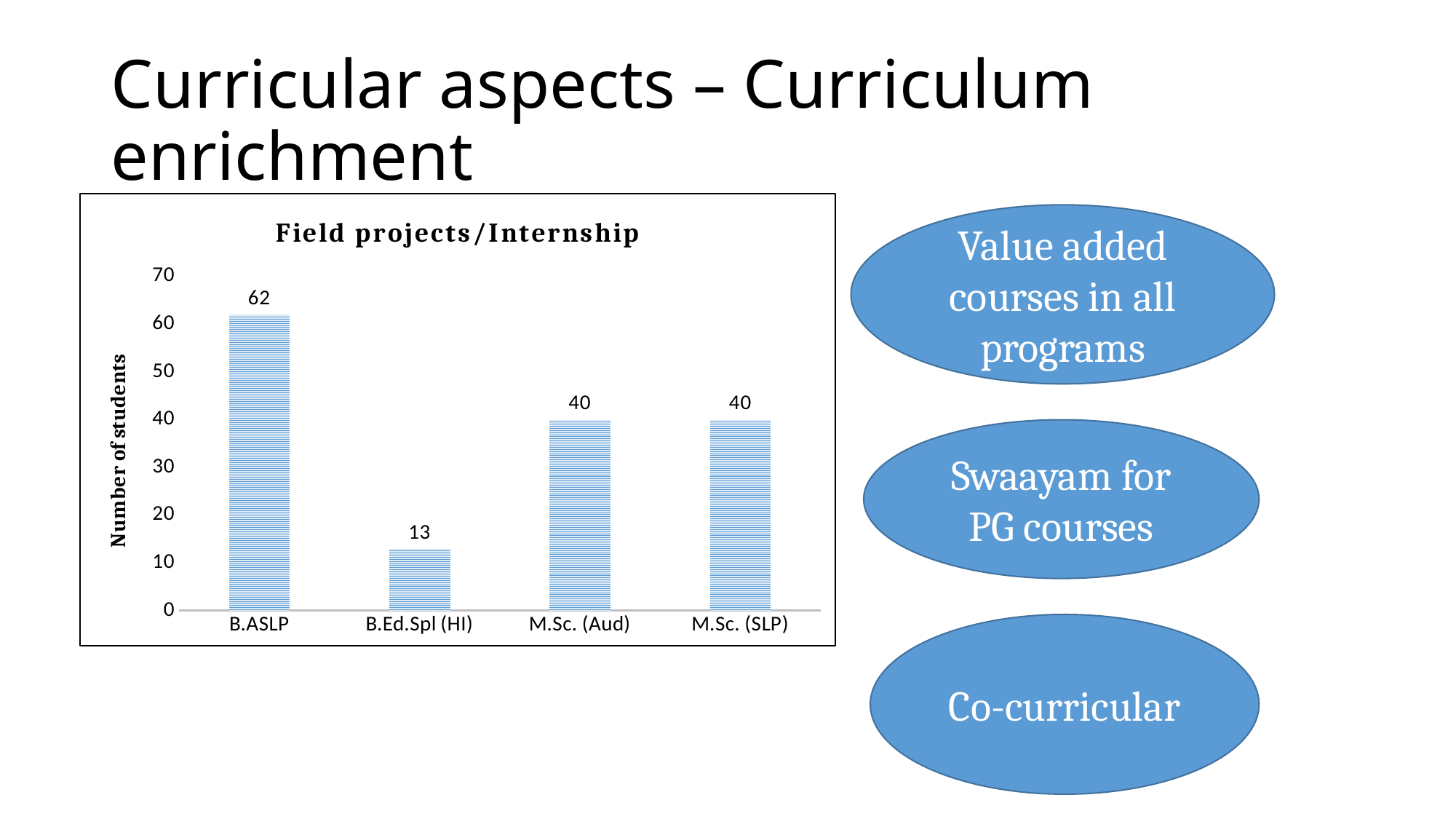
What is the number of students for M.Sc. (Aud)? 40 What kind of chart is shown on the slide? bar chart What is the title of the chart? Field projects/Internship What is the difference in number of students between B.ASLP and M.Sc. (SLP)? 22 What is the number of students for B.ASLP? 62 What is the difference in number of students between B.ASLP and B.Ed.Spl (HI)? 49 Which program has the lowest number of students? B.Ed.Spl (HI) Which program has the highest number of students? B.ASLP Which has more students, B.ASLP or M.Sc. (Aud)? B.ASLP Is the value for B.Ed.Spl (HI) greater or less than 20? less What is the number of students for B.Ed.Spl (HI)? 13 How many programs are shown on the x axis of the chart? 4